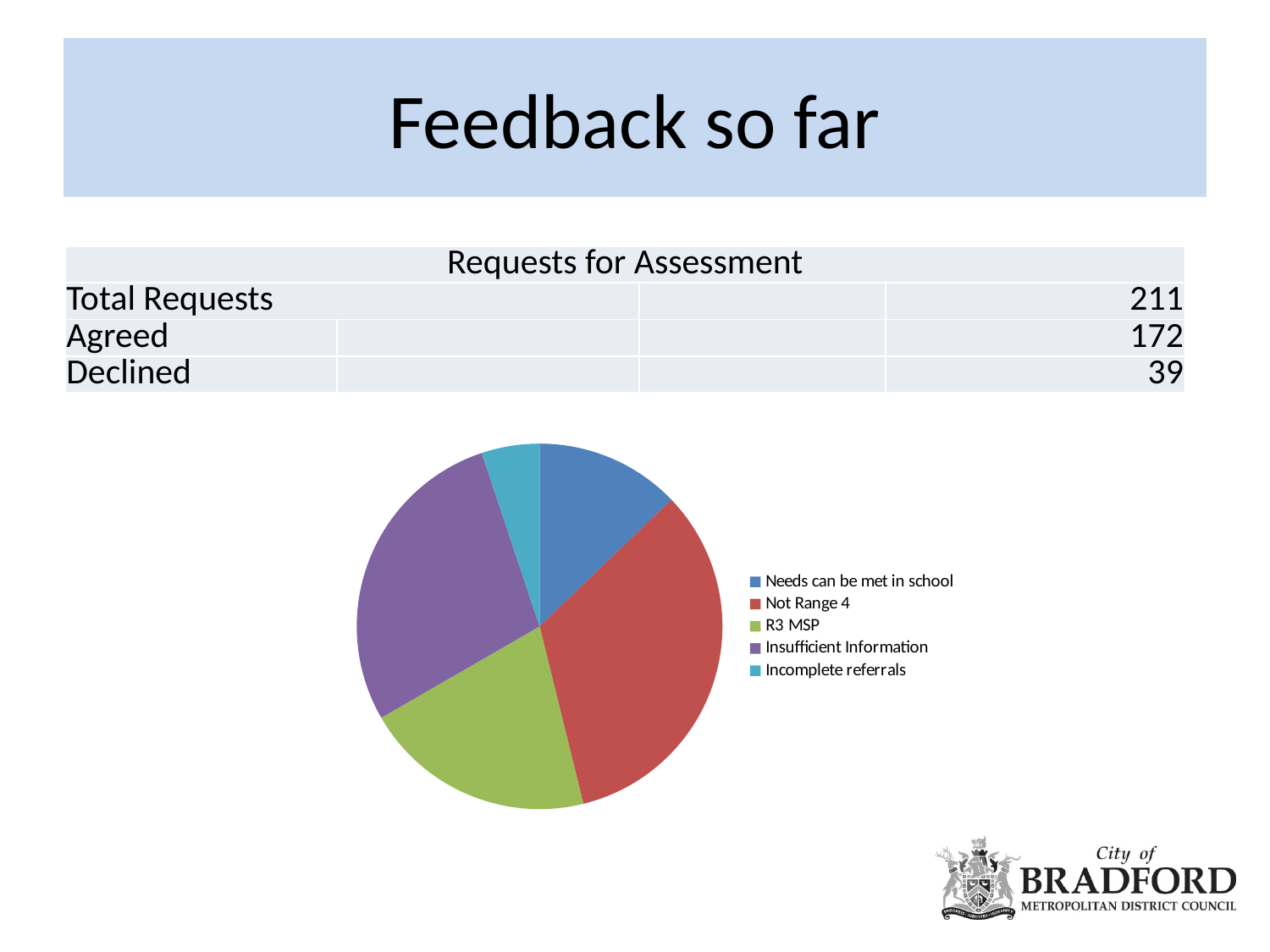
Which category has the smallest slice of the pie chart? Incomplete referrals What kind of chart is shown on the slide? Pie chart Which legend entry in the pie chart is shown in purple? Insufficient Information Which slice is larger in the pie chart: Not Range 4 or Needs can be met in school? Not Range 4 What colour is the Not Range 4 slice in the pie chart? Red Which slice is larger in the pie chart: Insufficient Information or Incomplete referrals? Insufficient Information Which slice is larger in the pie chart: Not Range 4 or R3 MSP? Not Range 4 Which category has the largest slice of the pie chart? Not Range 4 How many slices does the pie chart have? 5 How many entries does the pie chart's legend list? 5